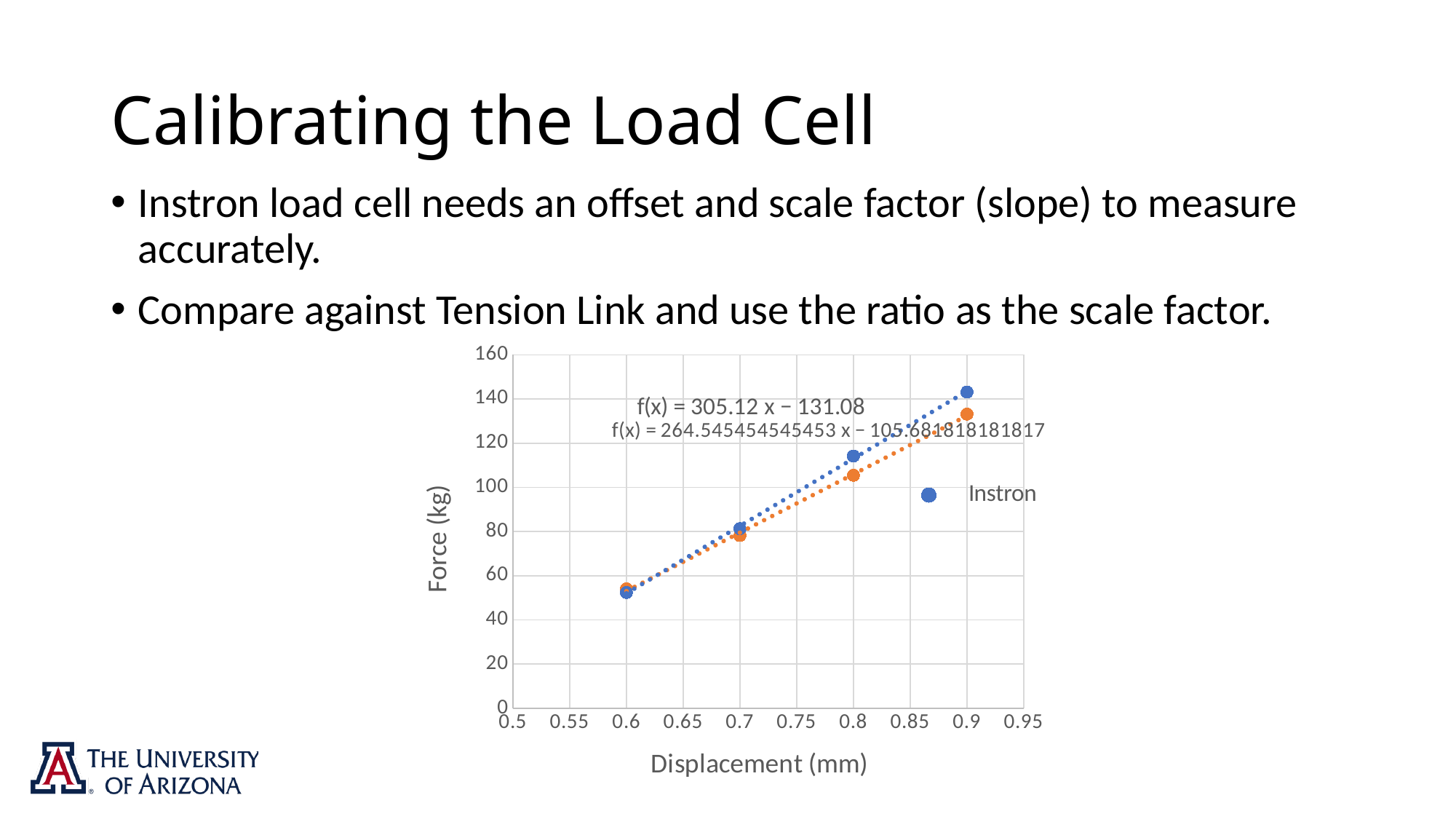
At a displacement of 0.6 mm, is the blue Instron value greater or less than 60? less At a displacement of 0.9 mm, which series has the higher Force value, the blue Instron series or the orange series? Blue Instron series At a displacement of 0.8 mm, is the blue Instron value greater or less than 100? greater What is the title of the horizontal axis of the chart? Displacement (mm) How many data points does the blue Instron series have? 4 At which displacement does the orange series have its lowest Force value? 0.6 What is the title of the vertical axis of the chart? Force (kg) Do the Force values rise or fall as Displacement increases? Rise At which displacement does the blue Instron series reach its highest Force value? 0.9 What kind of chart is shown on the slide? Scatter chart At a displacement of 0.9 mm, is the orange series value greater or less than 140? less